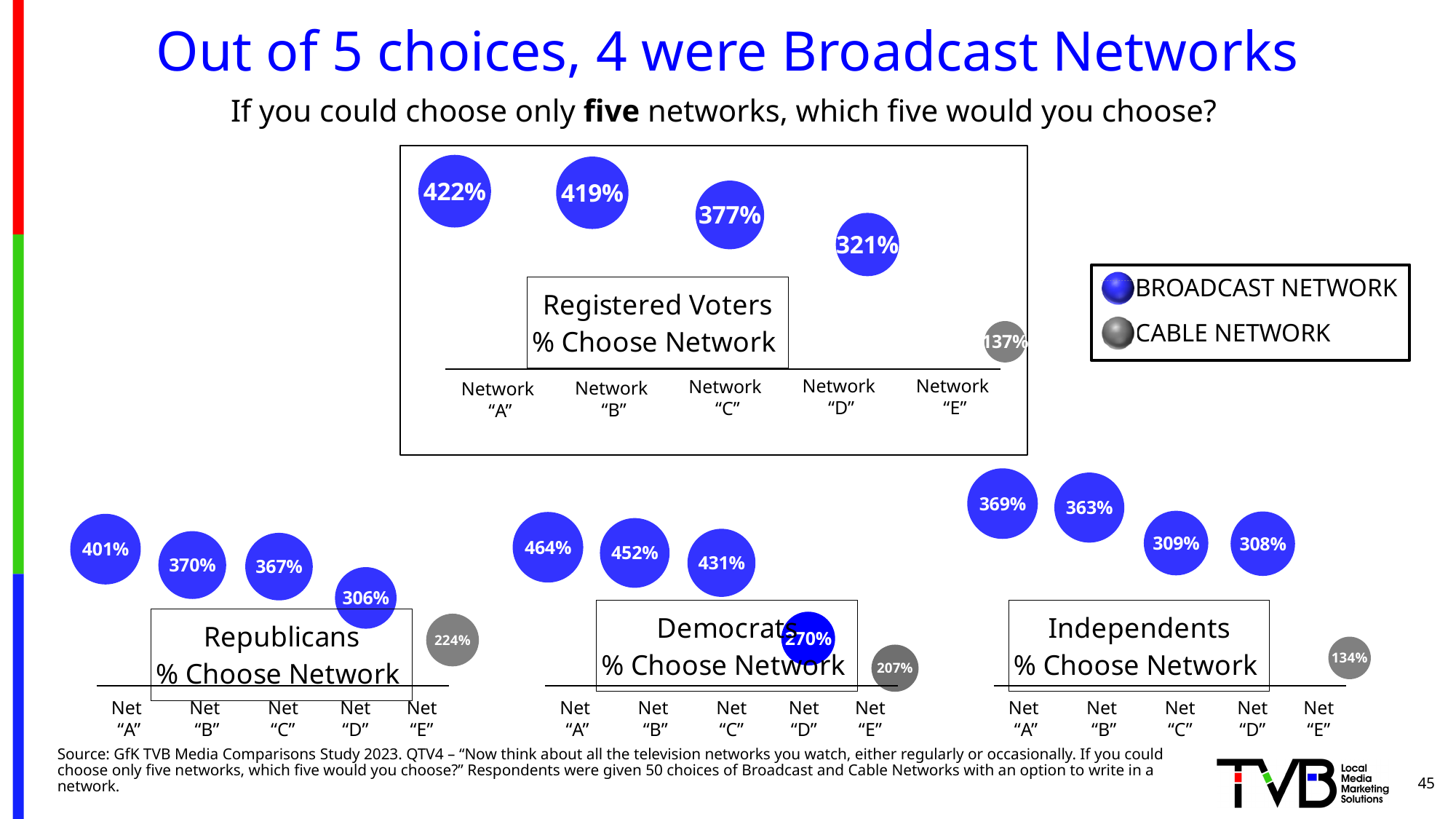
In the Democrats chart, which network has the highest value? Network "A" In the Republicans chart, what is the difference between Network "A" and Network "E"? 177% In the Registered Voters chart, which network has the lowest value? Network "E" In the Democrats chart, what is the value for Network "E"? 207% Is the value for Network "A" larger in the Democrats chart or the Republicans chart? Democrats How many networks are shown in the Registered Voters chart? 5 In the Independents chart, what is the difference between Network "A" and Network "E"? 235% In the Registered Voters chart, what percentage chose Network "A"? 422% Do the values in the Democrats chart rise or fall from Network "A" to Network "E"? fall In the Independents chart, what is the value for Network "B"? 363% In the Republicans chart, what is the value for Network "D"? 306% According to the legend, what type of network do the grey bubbles represent? Cable Network